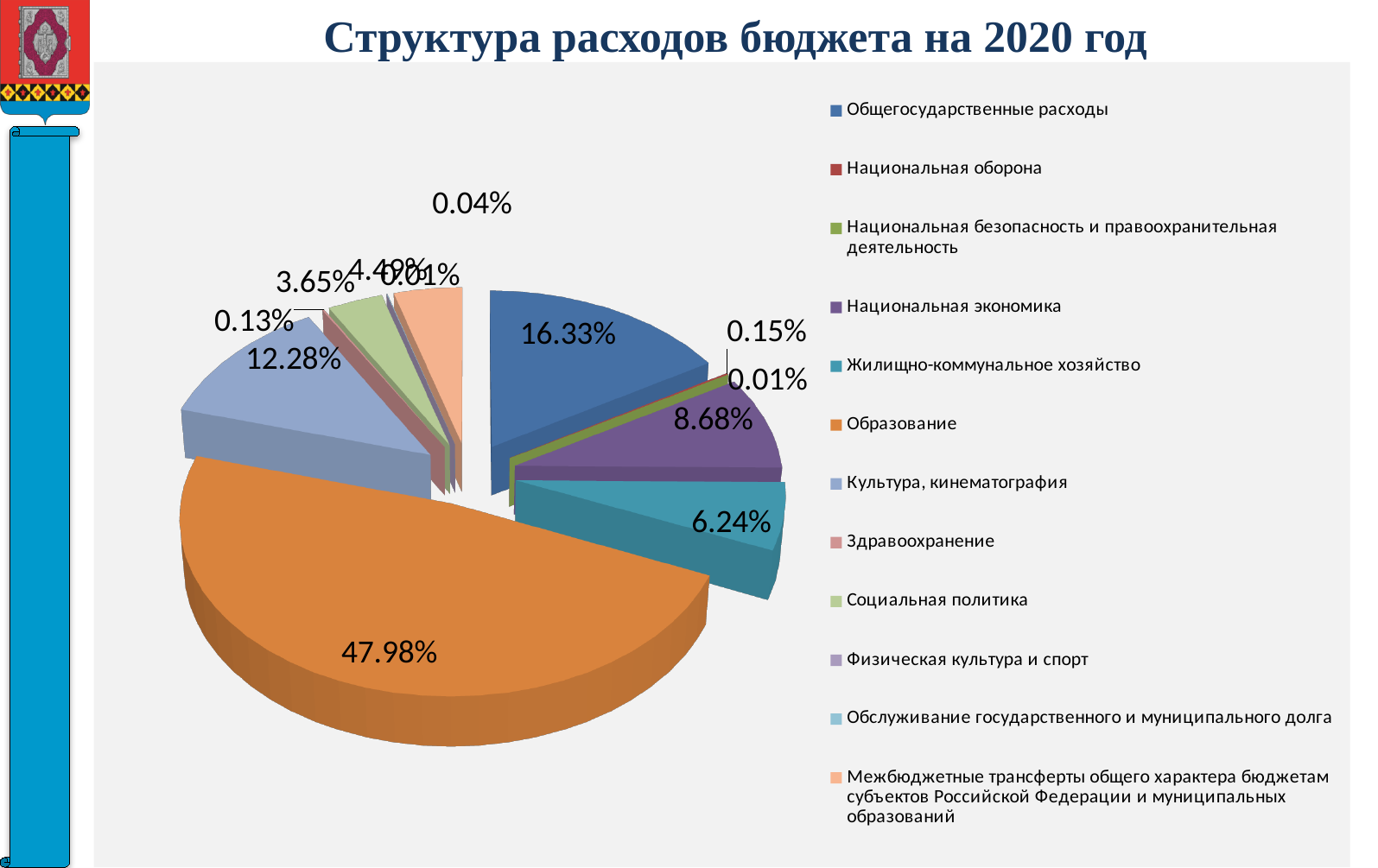
What percentage is shown for Культура, кинематография? 12.28% What is the value shown for Социальная политика? 3.65% What type of chart is shown on the slide? Pie chart What is the difference between the shares for Общегосударственные расходы and Культура, кинематография? 4.05% How many categories does the legend list? 12 Which category has the largest slice of the pie? Образование What share of the pie does Образование account for? 47.98% What is the title of the slide's chart? Структура расходов бюджета на 2020 год What share is shown for Жилищно-коммунальное хозяйство? 6.24% What is the value shown for Общегосударственные расходы? 16.33% Which is larger, the share for Культура, кинематография or the share for Национальная экономика? Культура, кинематография What is the value for Национальная экономика? 8.68%